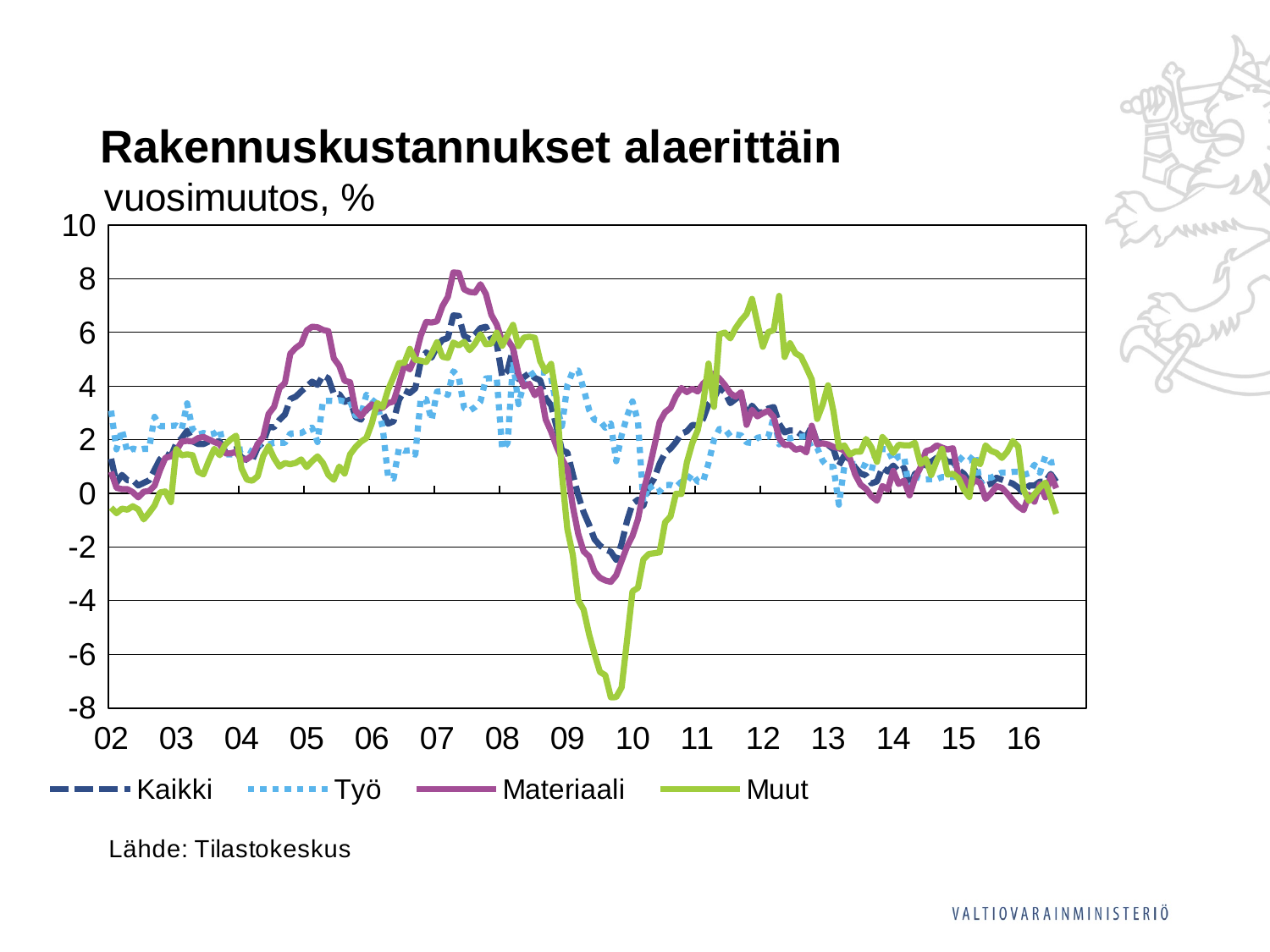
At the trough around 2009–2010, which series is lower, Muut or Materiaali? Muut What are the series names listed in the legend? Kaikki, Työ, Materiaali, Muut What is the title of the chart? Rakennuskustannukset alaerittäin Which series reaches the lowest value anywhere on the chart? Muut What kind of chart is shown on the slide? line chart How many year labels are shown on the x axis? 15 Does the Muut series generally rise or fall from its 2012 peak to 2016? fall Which series reaches the highest value anywhere on the chart? Materiaali Is the lowest value of Muut around 2009–2010 greater or less than -6? less Is the peak value of Muut around 2012 greater or less than 6? greater How many series does the legend list? 4 Is the peak value of Materiaali around 2007 greater or less than 6? greater